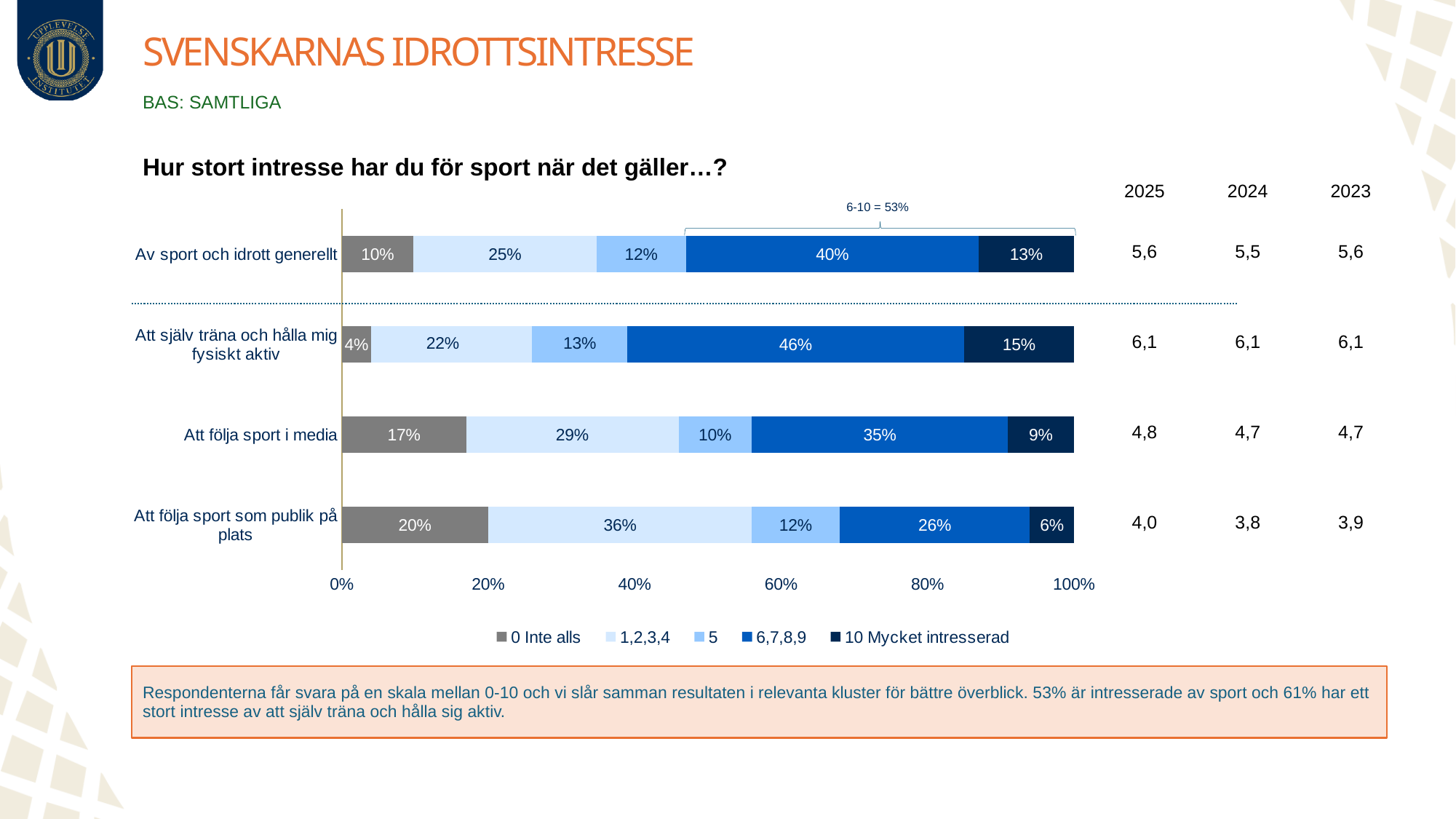
What is the value of the "0 Inte alls" segment for "Att följa sport som publik på plats"? 20% What is the difference between the "1,2,3,4" segment for "Att följa sport som publik på plats" and for "Av sport och idrott generellt"? 11% What is the last entry in the chart's legend? 10 Mycket intresserad How many series does the legend list? 5 How many categories are shown on the chart? 4 What is the value of the "6,7,8,9" segment for "Att själv träna och hålla mig fysiskt aktiv"? 46% What kind of chart is shown on the slide? Stacked bar chart Which is larger: the "6,7,8,9" segment for "Att följa sport i media" or for "Att följa sport som publik på plats"? Att följa sport i media Which category has the highest value for the "10 Mycket intresserad" segment? Att själv träna och hålla mig fysiskt aktiv Which category has the lowest value for the "0 Inte alls" segment? Att själv träna och hålla mig fysiskt aktiv What is the value of the "10 Mycket intresserad" segment for "Av sport och idrott generellt"? 13% What is the combined value of the "6,7,8,9" and "10 Mycket intresserad" segments for "Att följa sport i media"? 44%